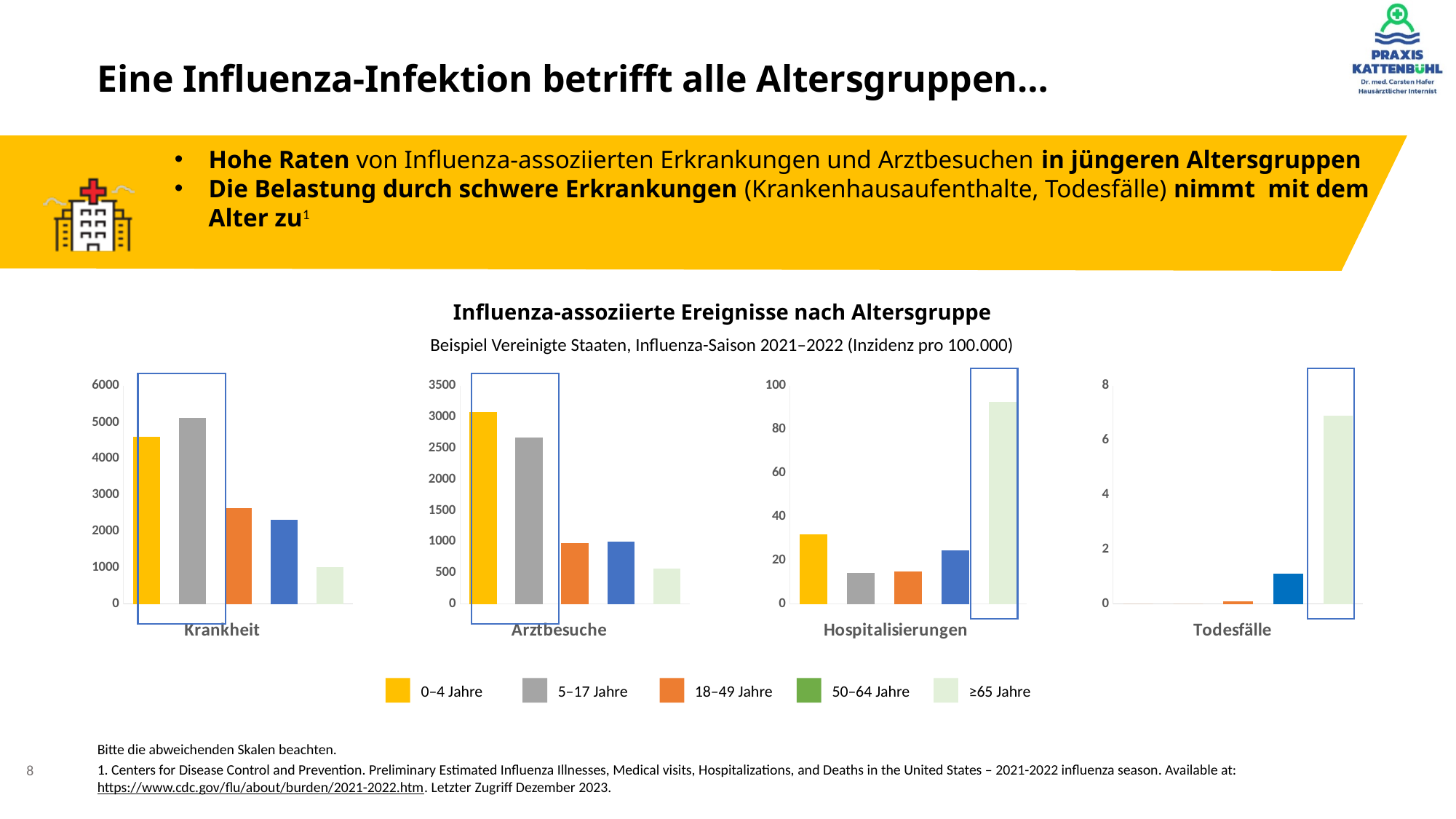
In the Krankheit chart, which age group has the lowest value? ≥65 Jahre What kind of chart is used for the Krankheit panel? bar chart In the Todesfälle chart, is the value for ≥65 Jahre greater or less than 6? greater In the Krankheit chart, is the value for 0–4 Jahre greater or less than 4000? greater In the Hospitalisierungen chart, is the value for ≥65 Jahre greater or less than 80? greater In the Hospitalisierungen chart, which age group has the highest value? ≥65 Jahre In the Hospitalisierungen chart, which is larger: the value for 0–4 Jahre or for 50–64 Jahre? 0–4 Jahre How many separate charts (panels) are shown under the title 'Influenza-assoziierte Ereignisse nach Altersgruppe'? 4 How many series does the legend list? 5 In the Krankheit chart, which age group has the highest value? 5–17 Jahre In the Arztbesuche chart, which age group has the highest value? 0–4 Jahre